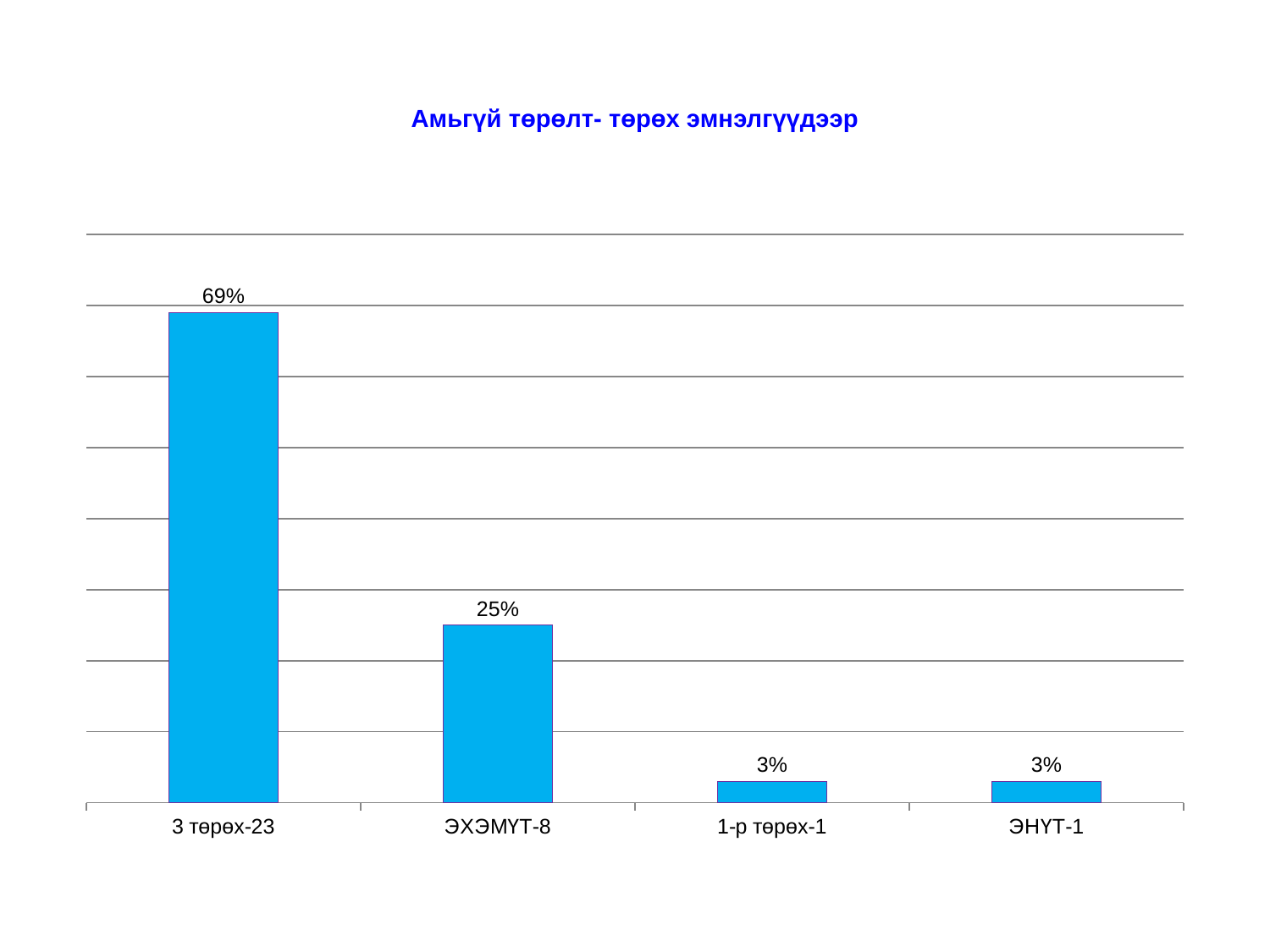
What kind of chart is shown on the slide? Bar chart Which category has the highest value? 3 төрөх-23 Do the values rise or fall from left to right along the x axis? Fall What is the title of the chart? Амьгүй төрөлт- төрөх эмнэлгүүдээр Which is larger, the value for ЭХЭМҮТ-8 or the value for 1-р төрөх-1? ЭХЭМҮТ-8 How many categories are shown on the x axis? 4 What is the value for ЭНҮТ-1? 3% What is the difference between the values for 3 төрөх-23 and ЭХЭМҮТ-8? 44% What is the value for ЭХЭМҮТ-8? 25% What is the value for 3 төрөх-23? 69% What is the value for 1-р төрөх-1? 3% What is the difference between the values for ЭХЭМҮТ-8 and ЭНҮТ-1? 22%